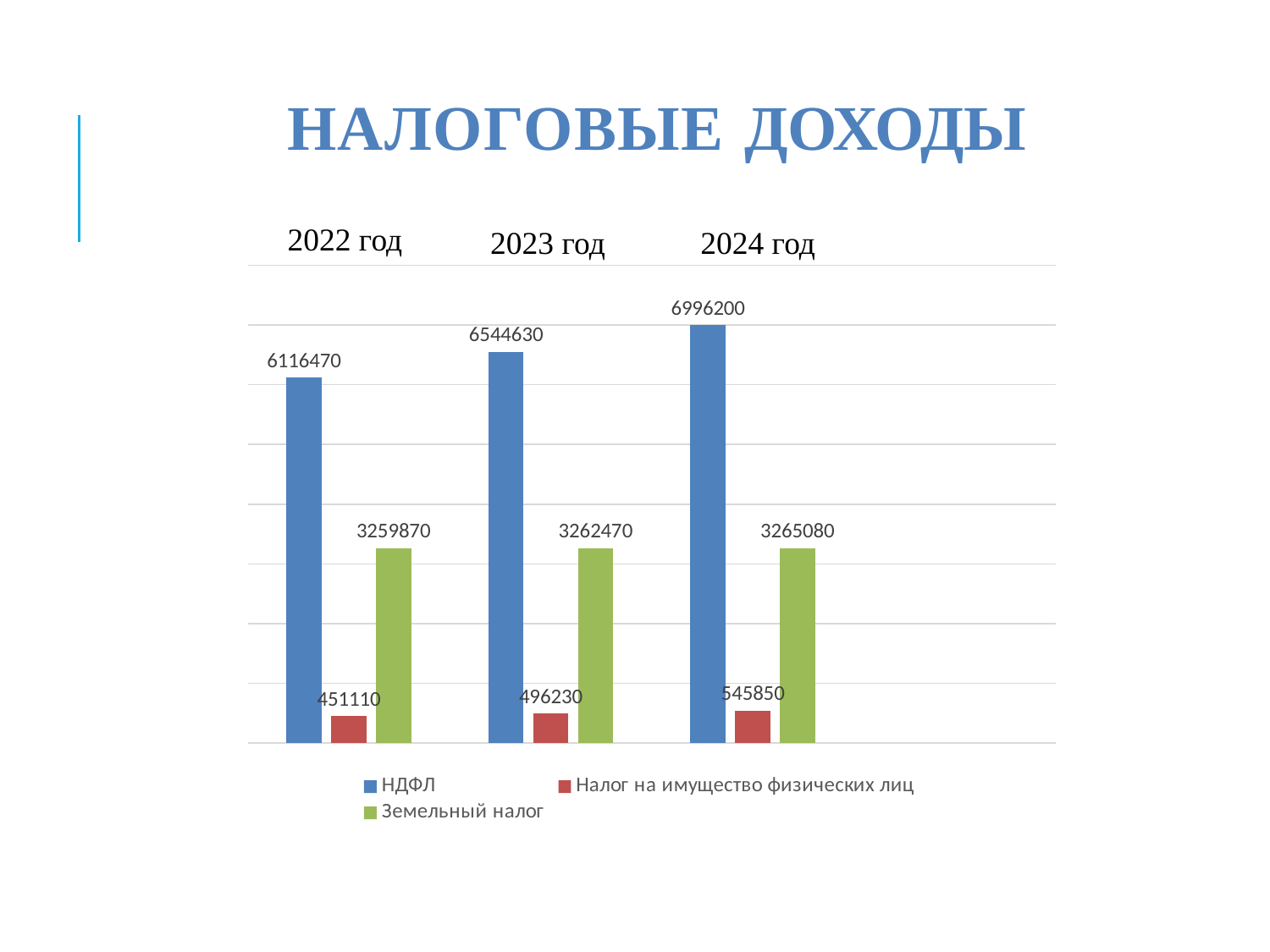
What is the difference between НДФЛ in 2024 год and НДФЛ in 2023 год? 451570 Which is larger in 2023 год: НДФЛ or Земельный налог? НДФЛ What is the value of НДФЛ for 2022 год? 6116470 How many year categories are shown on the chart? 3 Does НДФЛ rise or fall from 2022 год to 2024 год? Rise What is the difference between Налог на имущество физических лиц in 2024 год and in 2022 год? 94740 In which year is НДФЛ highest? 2024 год What kind of chart is shown on the slide? Bar chart What is the value of Земельный налог for 2024 год? 3265080 How many series does the legend list? 3 In which year is Налог на имущество физических лиц lowest? 2022 год What is the value of Налог на имущество физических лиц for 2023 год? 496230